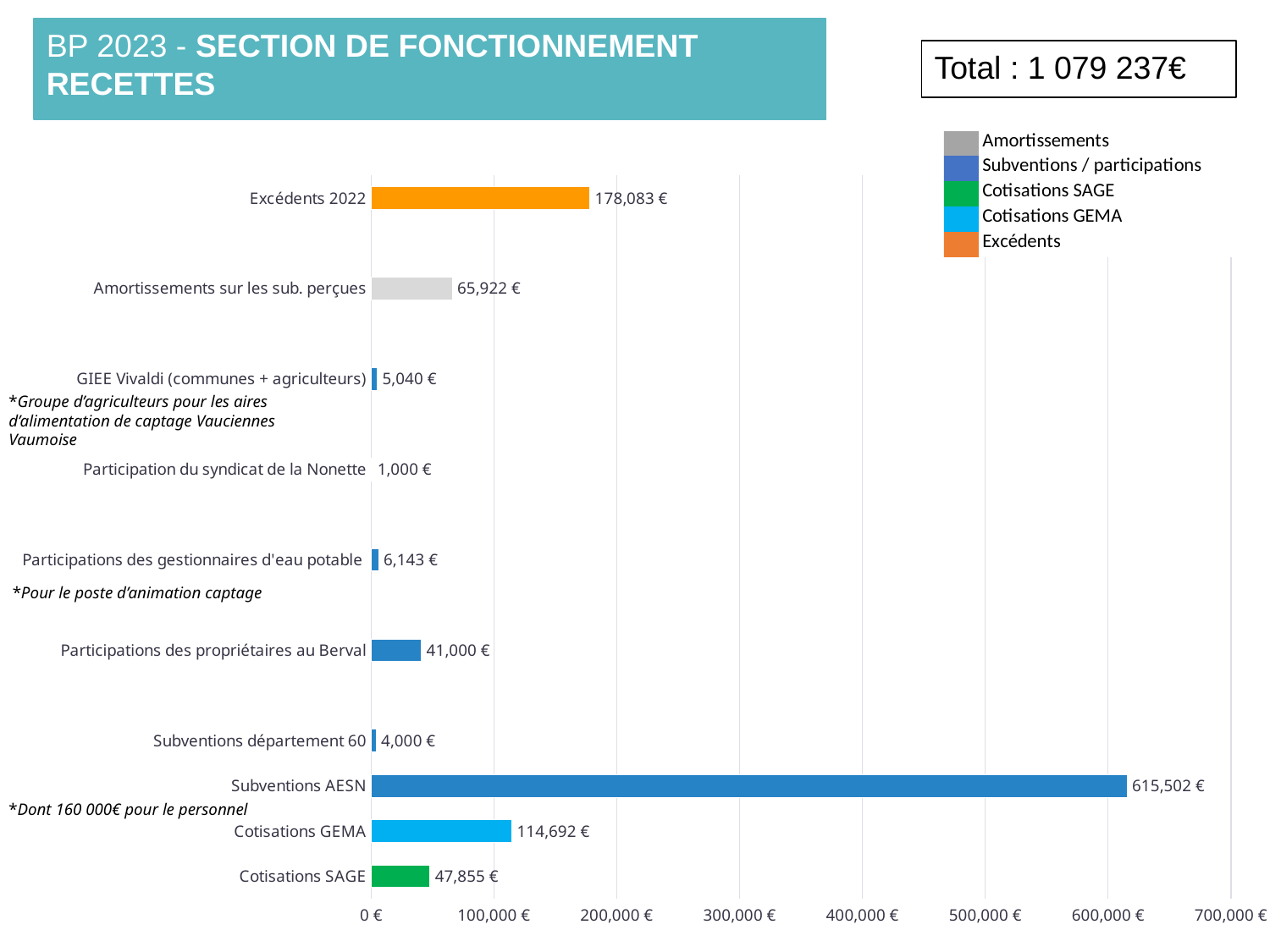
What is the value for Subventions AESN? 615,502 € Is the value for Subventions AESN greater or less than 600,000 €? greater What is the value for Cotisations GEMA? 114,692 € Which is larger: Participations des propriétaires au Berval or Cotisations SAGE? Cotisations SAGE What is the value for Excédents 2022? 178,083 € Which category has the lowest value? Participation du syndicat de la Nonette What is the difference between Cotisations GEMA and Cotisations SAGE? 66,837 € Which category has the highest value? Subventions AESN How many entries does the legend list? 5 How many categories are shown in the chart? 10 What total is shown in the box at the top right of the slide? 1 079 237€ What kind of chart is shown on the slide? bar chart